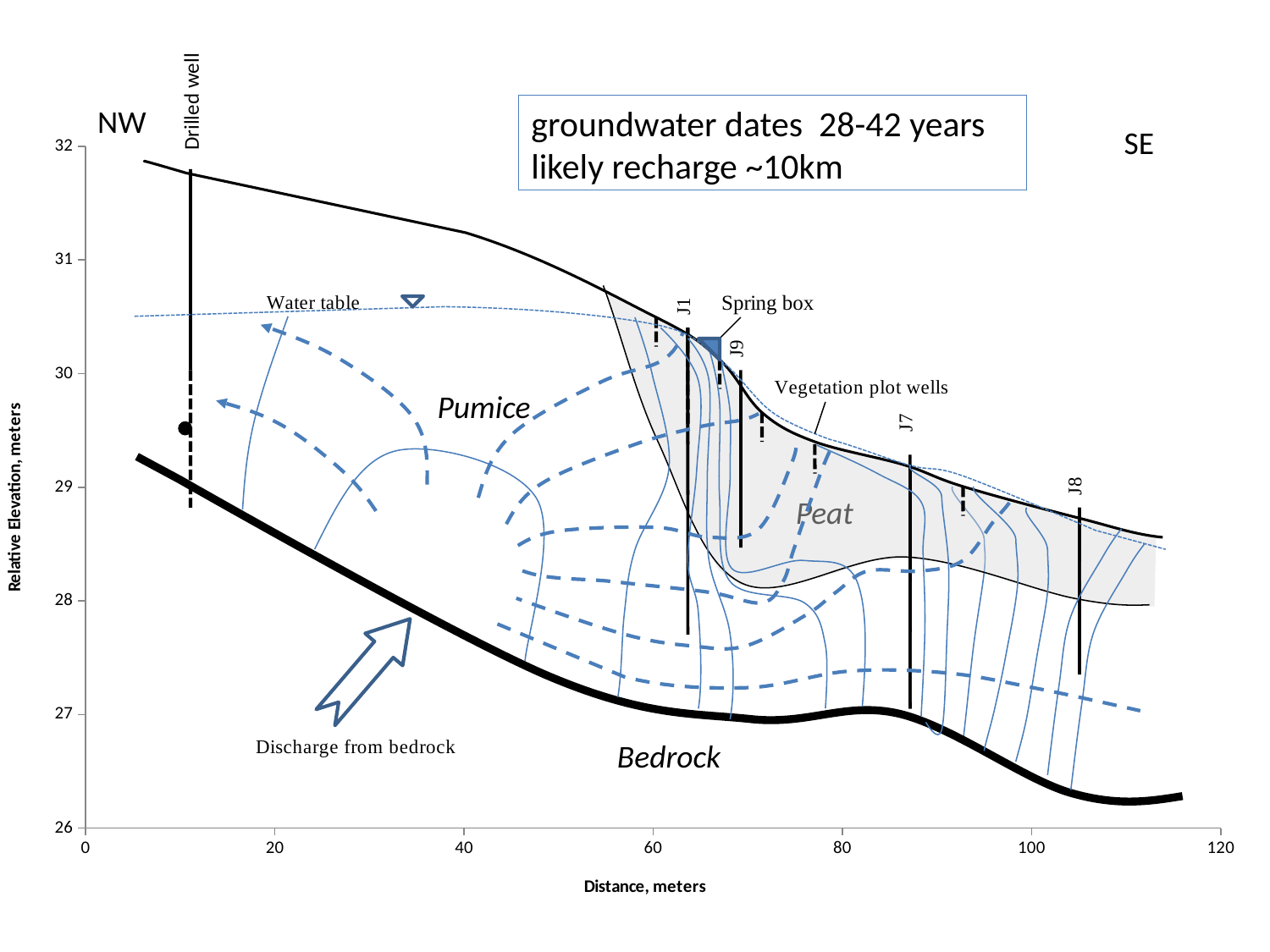
Is the bedrock surface higher at a distance of 20 meters or at a distance of 100 meters? 20 meters Is the ground surface elevation at a distance of 20 meters greater or less than 31? greater Does the ground surface elevation rise or fall as distance increases from NW to SE? fall Is the bedrock surface elevation at a distance of 80 meters greater or less than 28? less Is the water table elevation at a distance of 40 meters greater or less than 30? greater Which labeled J well is located at the greatest distance along the x axis? J8 What is the title of the x axis? Distance, meters What is the highest value shown on the y axis? 32 How many wells labeled with a J number are shown on the cross-section? 4 What is the largest tick value shown on the x axis? 120 What is the title of the y axis? Relative Elevation, meters What range of groundwater dates is stated in the text box on the slide? 28-42 years